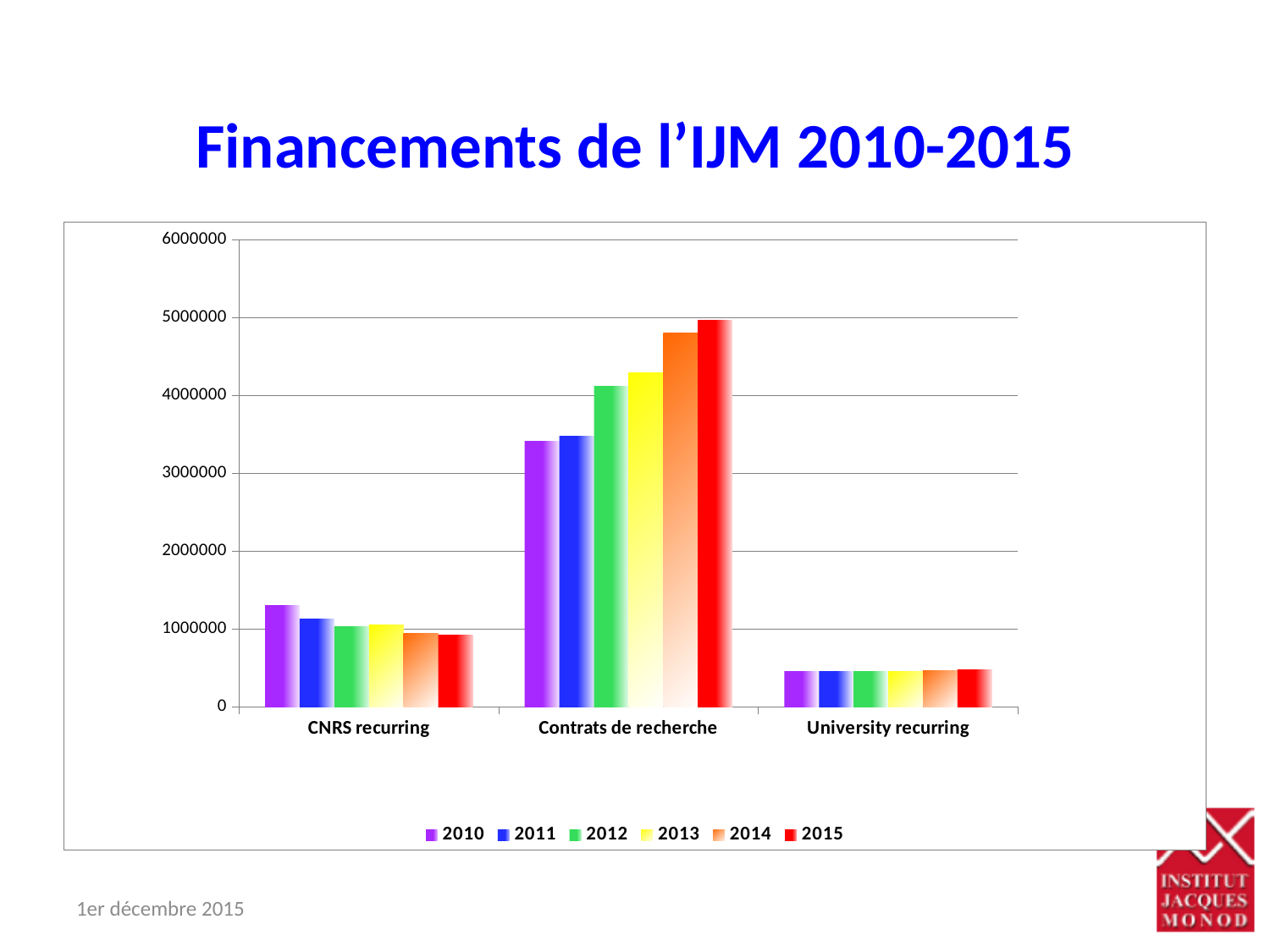
What kind of chart is shown on the slide? bar chart For CNRS recurring, which is larger: the value for 2010 or the value for 2015? 2010 Which category has the lowest value for 2010? University recurring How many series does the legend list? 6 Do the values for Contrats de recherche rise or fall from 2010 to 2015? rise Is the value for University recurring in 2012 greater or less than 1000000? less Is the value for CNRS recurring in 2010 greater or less than 1000000? greater For Contrats de recherche, which is larger: the value for 2010 or the value for 2015? 2015 Is the value for Contrats de recherche in 2015 greater or less than 4000000? greater How many categories are shown on the x axis? 3 Which category has the highest value for 2015? Contrats de recherche